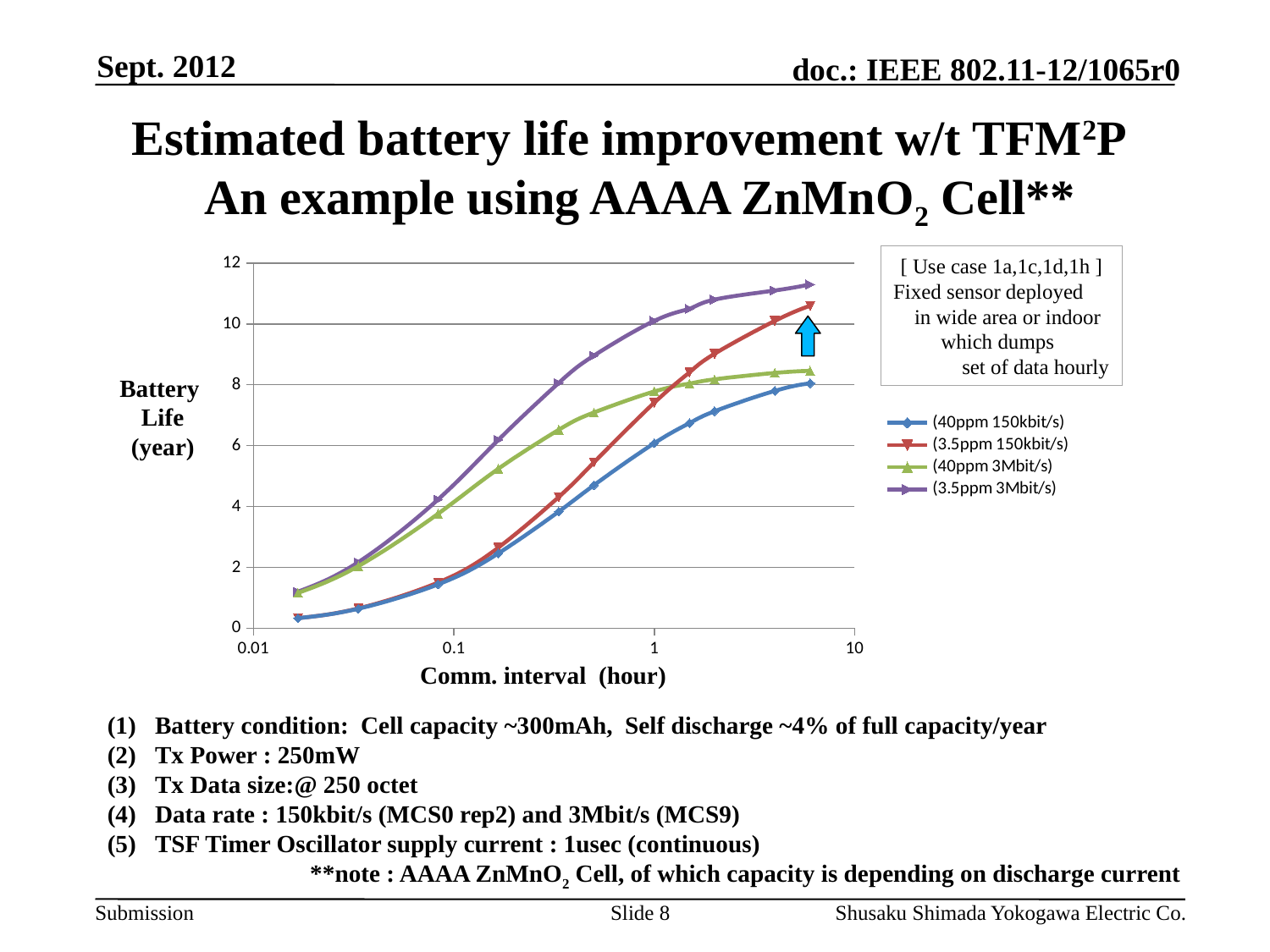
Which series has the lowest battery life at the largest comm. interval plotted? (40ppm 150kbit/s) Do the battery life values rise or fall as the comm. interval increases along the x axis? rise Is the battery life for (40ppm 3Mbit/s) at a comm. interval of 1 hour greater or less than 6? greater Is the battery life for (3.5ppm 3Mbit/s) at a comm. interval of 0.1 hour greater or less than 6? less Which series has the highest battery life at the largest comm. interval plotted? (3.5ppm 3Mbit/s) What kind of chart is shown on the slide? line chart At the largest comm. interval plotted, which series has the larger battery life, (3.5ppm 150kbit/s) or (40ppm 3Mbit/s)? (3.5ppm 150kbit/s) Is the battery life for (40ppm 150kbit/s) at a comm. interval of 1 hour greater or less than 8? less What is the label of the chart's y axis? Battery Life (year) How many series does the chart's legend list? 4 What is the label of the chart's x axis? Comm. interval (hour) At a comm. interval of 0.1 hour, which series has the larger battery life, (40ppm 3Mbit/s) or (40ppm 150kbit/s)? (40ppm 3Mbit/s)